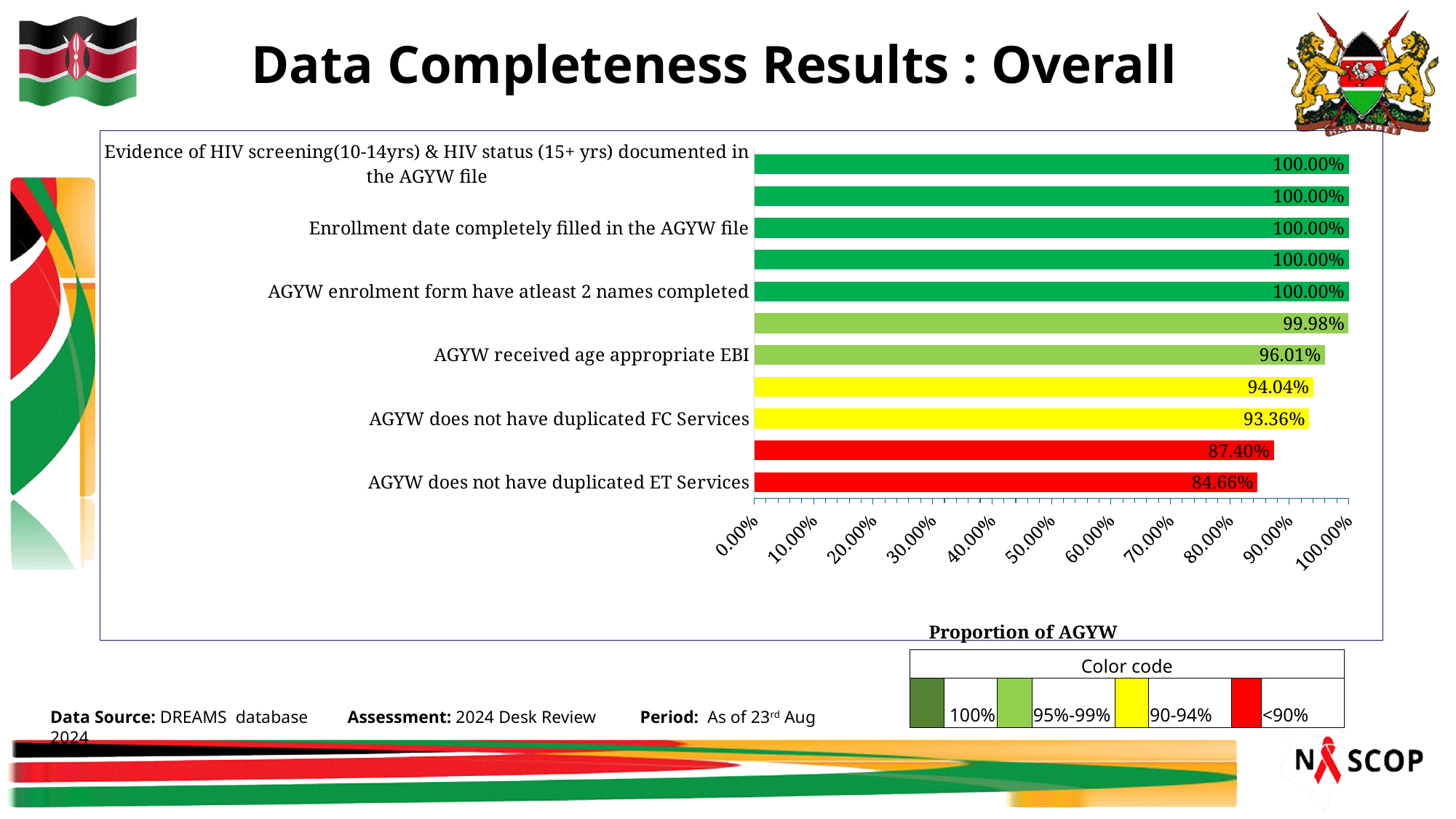
How many bars are plotted in the chart? 11 What is the difference between the values for "AGYW received age appropriate EBI" and "AGYW does not have duplicated ET Services"? 11.35% What is the value for "AGYW received age appropriate EBI"? 96.01% What kind of chart is shown on the slide? Bar chart Which is larger: the value for "AGYW received age appropriate EBI" or for "AGYW does not have duplicated FC Services"? AGYW received age appropriate EBI Is the value for "AGYW does not have duplicated ET Services" greater or less than 90.00%? less What is the value for "AGYW does not have duplicated FC Services"? 93.36% What is the value for "AGYW does not have duplicated ET Services"? 84.66% What is the difference between the values for "AGYW does not have duplicated FC Services" and "AGYW does not have duplicated ET Services"? 8.70% Which labelled category has the lowest value? AGYW does not have duplicated ET Services According to the color code, what range of values is shown in red? <90% What is the value for "Enrollment date completely filled in the AGYW file"? 100.00%